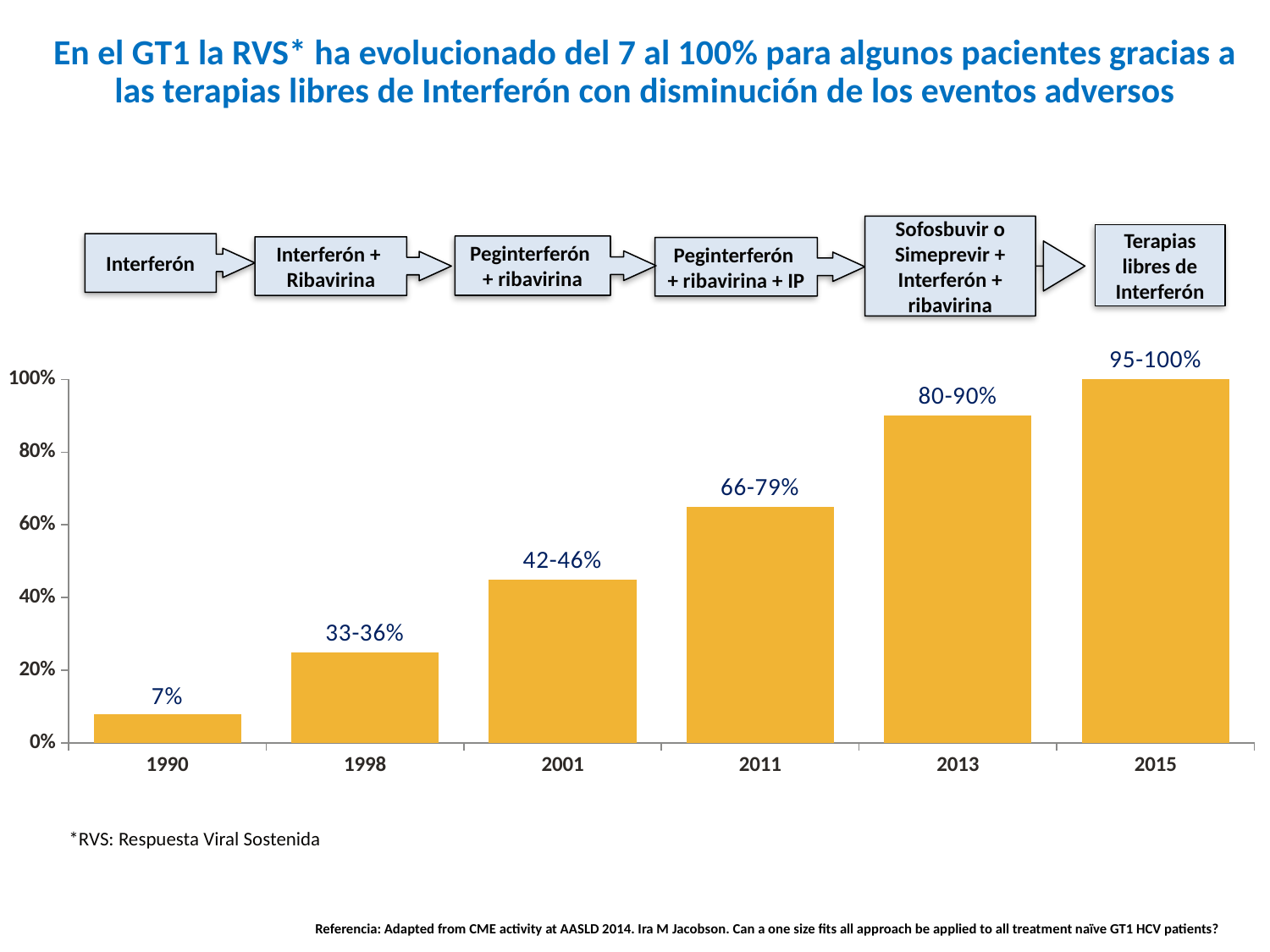
Is the bar for 2011 greater or less than 60%? greater Which year has the lowest bar in the chart? 1990 What is the data label shown for 2011? 66-79% What is the data label shown for 2001? 42-46% How many years (bars) are shown on the x axis of the chart? 6 What is the data label shown for 1990? 7% What is the data label shown for 2013? 80-90% What is the data label shown for 1998? 33-36% Do the bar values rise or fall from 1990 to 2015? rise What kind of chart is shown on the slide? bar chart Which year has the highest bar in the chart? 2015 What is the data label shown for 2015? 95-100%